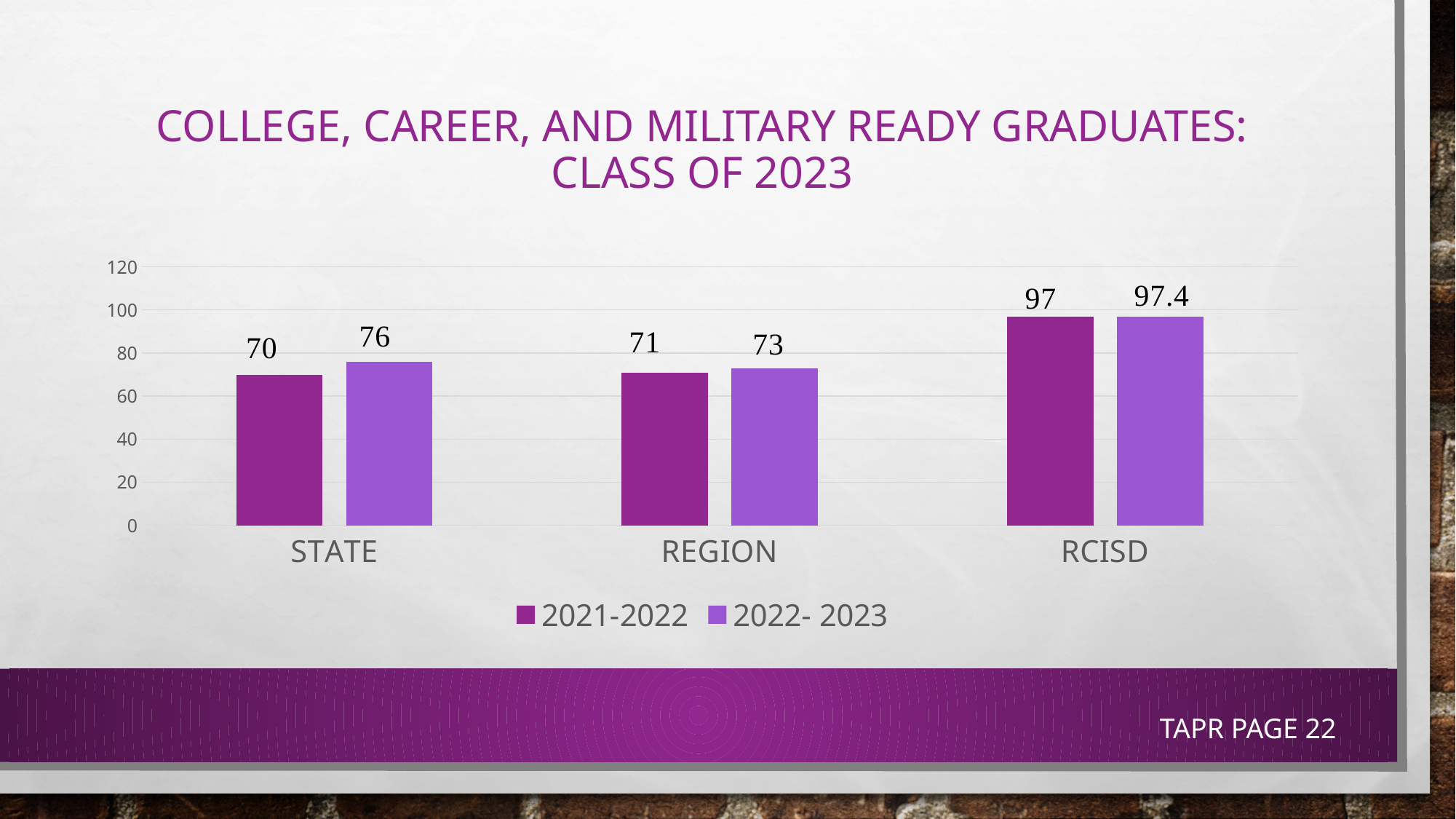
Which category has the lowest value in the 2022- 2023 series? REGION Which category has the highest value in the 2021-2022 series? RCISD What is the value for RCISD in the 2022- 2023 series? 97.4 What is the title of the chart on the slide? College, Career, and Military Ready Graduates: Class of 2023 How many categories are shown on the x axis? 3 What is the value for REGION in the 2022- 2023 series? 73 What is the difference between the RCISD and STATE values in the 2021-2022 series? 27 Which is larger: the 2022- 2023 value for STATE or the 2022- 2023 value for REGION? STATE What is the value for STATE in the 2021-2022 series? 70 How many series does the legend list? 2 What is the difference between the 2022- 2023 and 2021-2022 values for STATE? 6 What kind of chart is shown on the slide? Bar chart